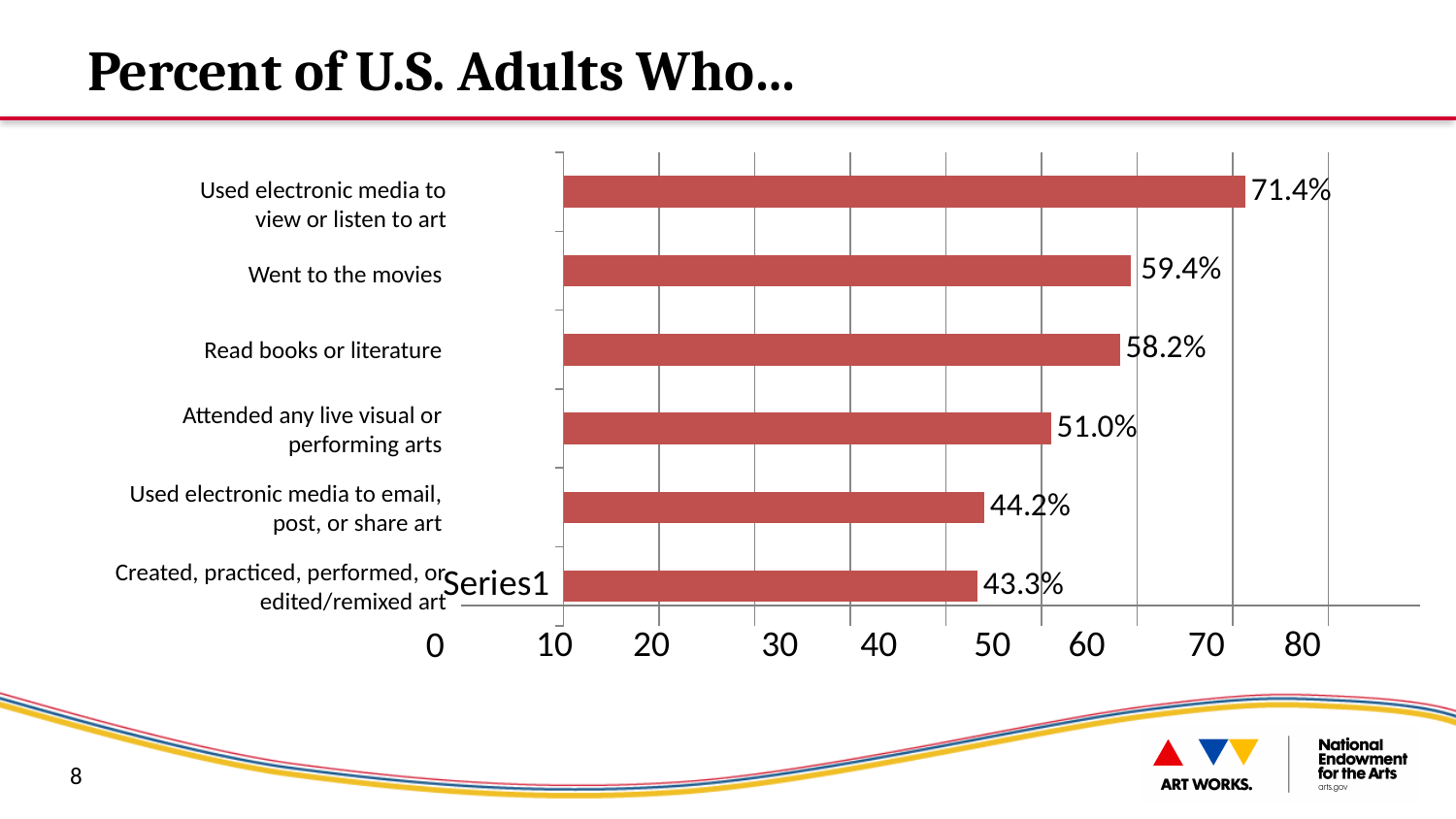
What percent of U.S. adults created, practiced, performed, or edited/remixed art? 43.3% What is the difference between 'Used electronic media to email, post, or share art' and 'Created, practiced, performed, or edited/remixed art'? 0.9% Which category has the lowest percentage? Created, practiced, performed, or edited/remixed art How many categories are shown in the chart? 6 What is the title of the slide? Percent of U.S. Adults Who… Which category has the highest percentage? Used electronic media to view or listen to art What is the value for 'Attended any live visual or performing arts'? 51.0% What type of chart is shown on the slide? Bar chart What percent of U.S. adults used electronic media to view or listen to art? 71.4% What percent of U.S. adults went to the movies? 59.4% Which is larger: the percentage who went to the movies or the percentage who read books or literature? Went to the movies What is the difference between the percentage who used electronic media to view or listen to art and the percentage who went to the movies? 12.0%